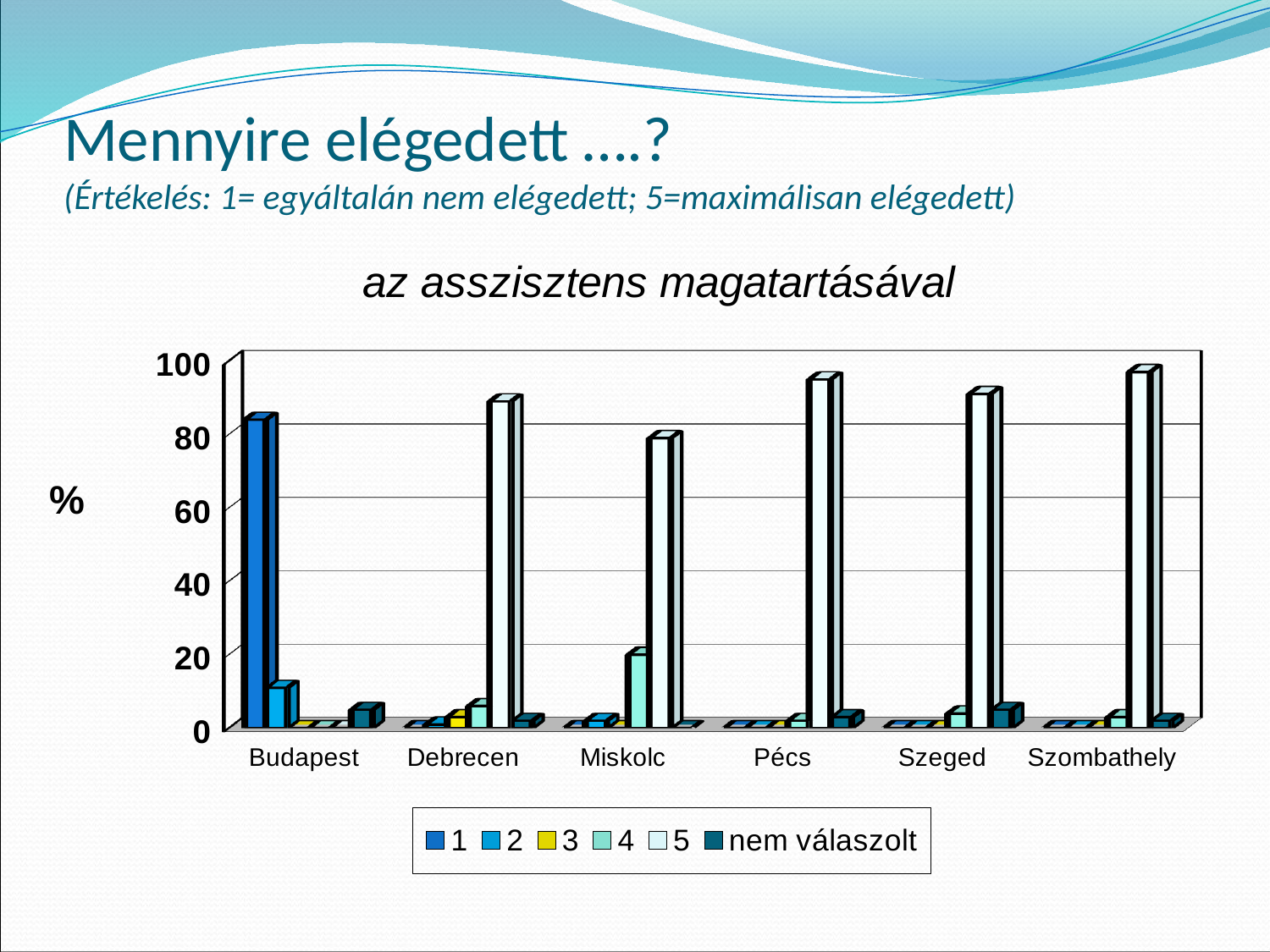
What is the label on the vertical axis of the chart? % Is the value for series 5 in Debrecen greater or less than 80? greater How many series does the chart legend list? 6 What kind of chart is shown on the slide? bar chart Is the value for series 4 in Miskolc greater or less than 40? less Is the value for series 1 in Budapest greater or less than 60? greater Which series has the highest value in Budapest? 1 What is the title of the chart? az asszisztens magatartásával Which series has the highest value in Debrecen? 5 Which is larger: the value for series 5 in Szombathely or the value for series 5 in Miskolc? Szombathely How many cities are shown on the x axis of the chart? 6